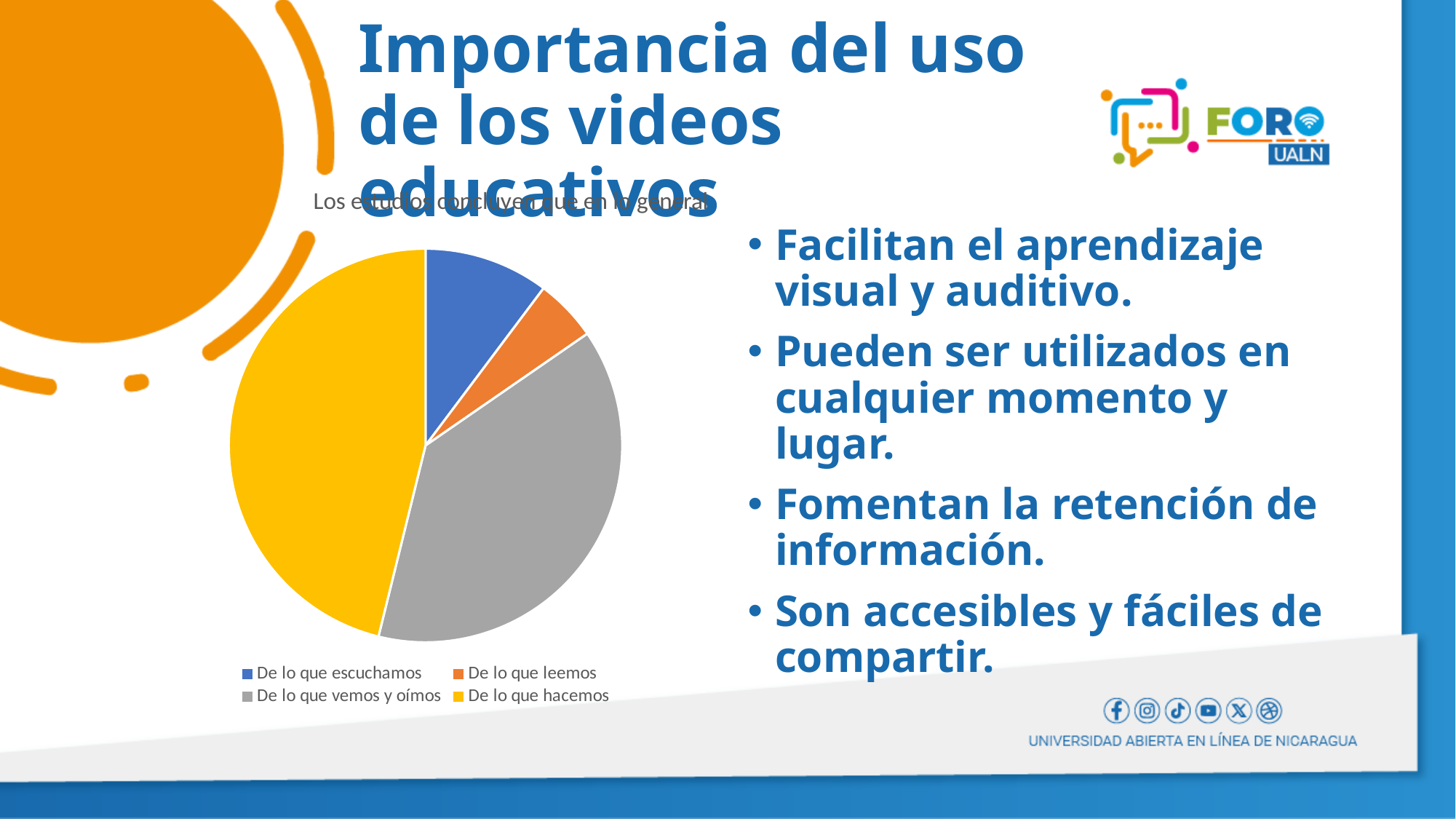
How many entries does the legend of the pie chart list? 4 Which category has the largest slice in the pie chart? De lo que hacemos Which slice is larger, 'De lo que escuchamos' or 'De lo que leemos'? De lo que escuchamos What colour is the slice for 'De lo que hacemos' in the pie chart? yellow How many slices does the pie chart have? 4 Which category is shown in gray in the pie chart? De lo que vemos y oímos Which slice is larger, 'De lo que vemos y oímos' or 'De lo que escuchamos'? De lo que vemos y oímos Which slice is larger, 'De lo que hacemos' or 'De lo que leemos'? De lo que hacemos What kind of chart is shown on the slide? pie chart Which category has the smallest slice in the pie chart? De lo que leemos